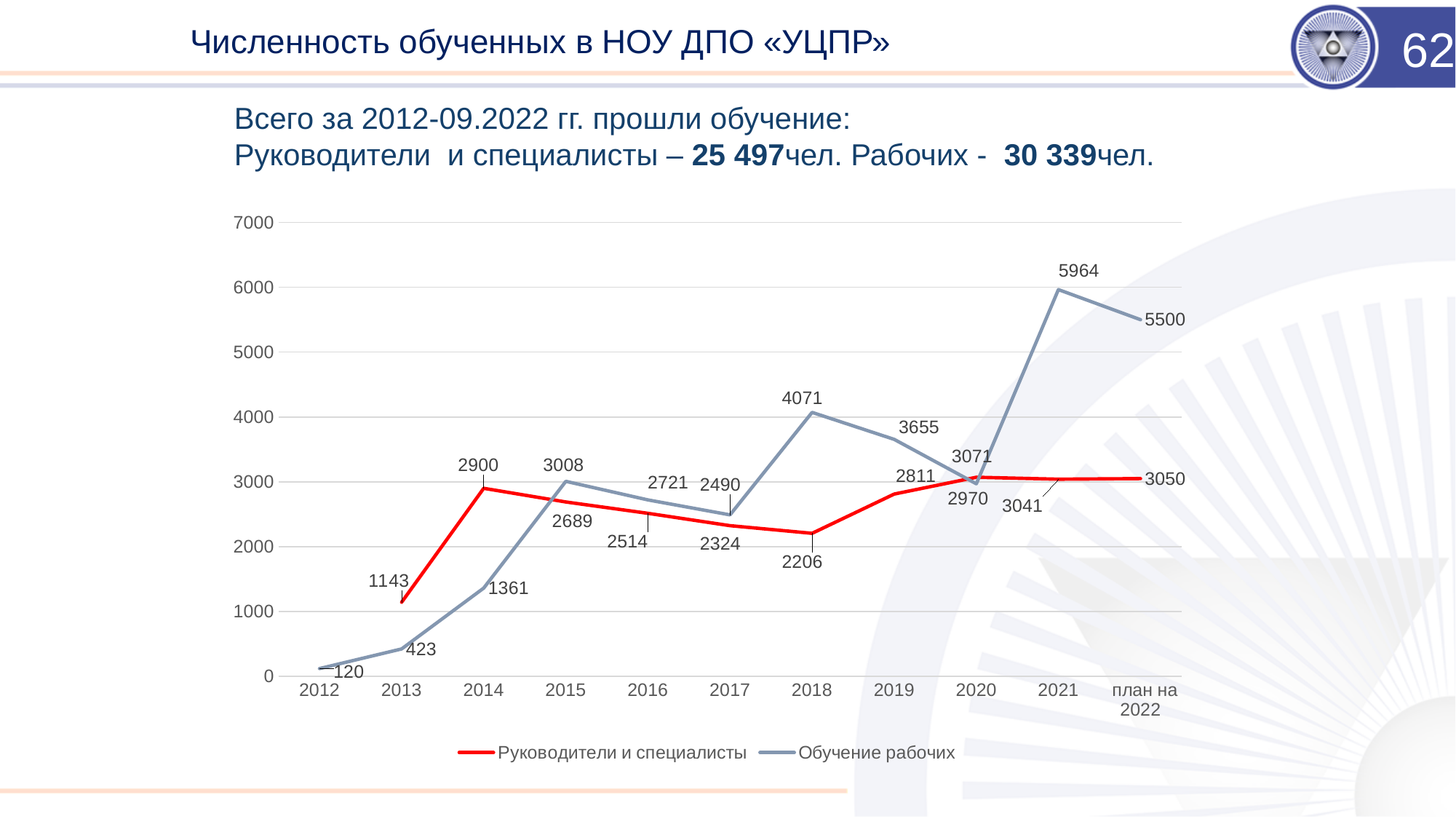
What is the planned value for Руководители и специалисты for план на 2022? 3050 Is the value for Руководители и специалисты in 2018 greater or less than 2000? greater In which year is the Руководители и специалисты value the lowest? 2013 How many categories are shown on the x axis? 11 Which series has the larger value in 2018? Обучение рабочих What is the value for Обучение рабочих in 2021? 5964 By how much does Обучение рабочих drop from 2021 to план на 2022? 464 How many series does the legend list? 2 What is the difference between Обучение рабочих and Руководители и специалисты in 2021? 2923 In which year does the Обучение рабочих series reach its highest value? 2021 In which year is the Обучение рабочих value the lowest? 2012 What is the value for Руководители и специалисты in 2014? 2900